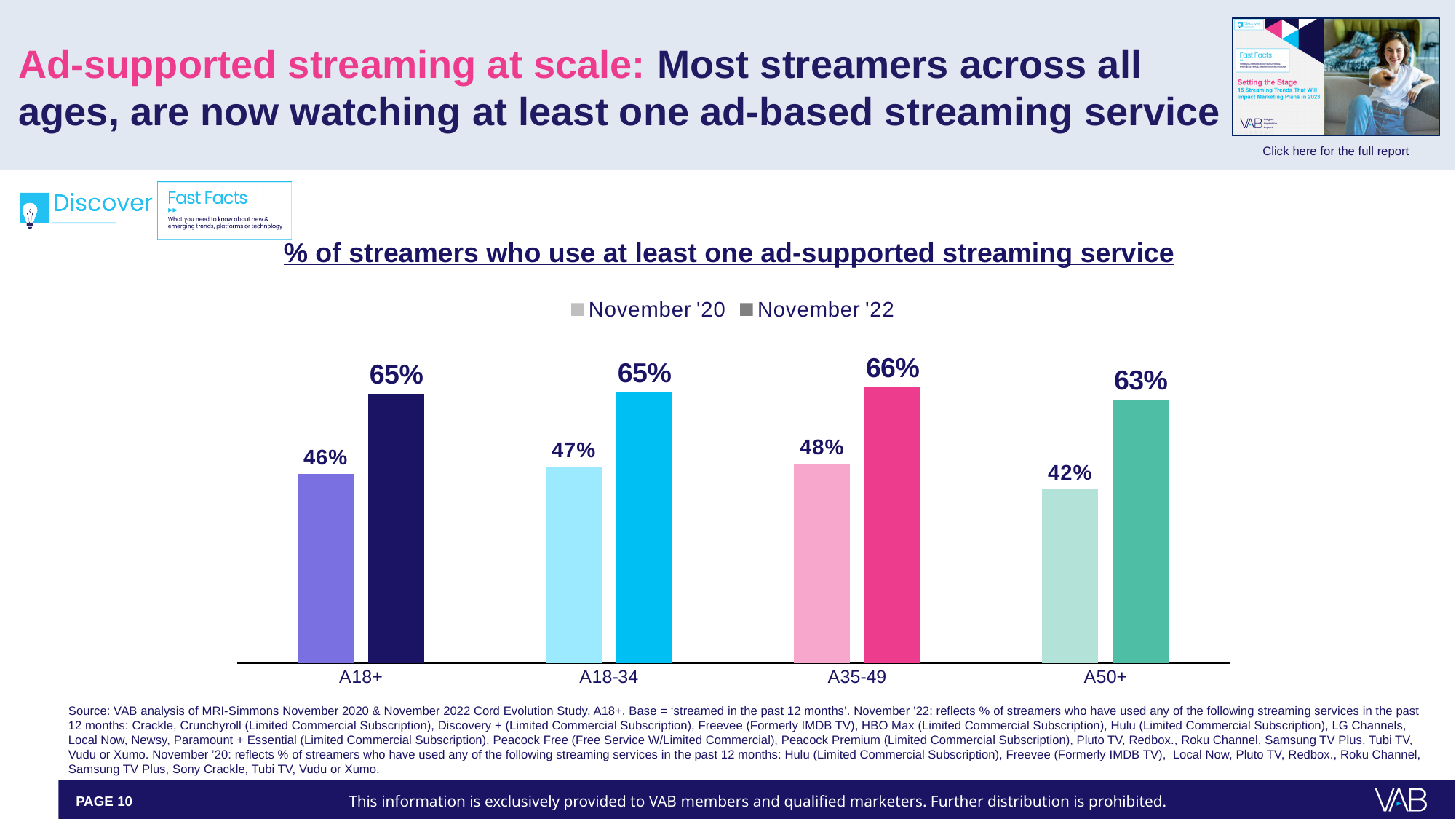
What is the November '22 value for A50+? 63% What is the difference between the November '22 and November '20 values for A18-34? 18 percentage points What is the difference between the November '22 and November '20 values for A50+? 21 percentage points Which age group has the highest November '22 value? A35-49 What is the November '22 value for A18+? 65% Which is larger for A35-49: the November '20 value or the November '22 value? November '22 What kind of chart is shown on the slide? Bar chart What is the November '20 value for A35-49? 48% What is the November '20 value for A50+? 42% How many age groups are shown on the x axis? 4 Which age group has the lowest November '20 value? A50+ How many series does the legend list? 2